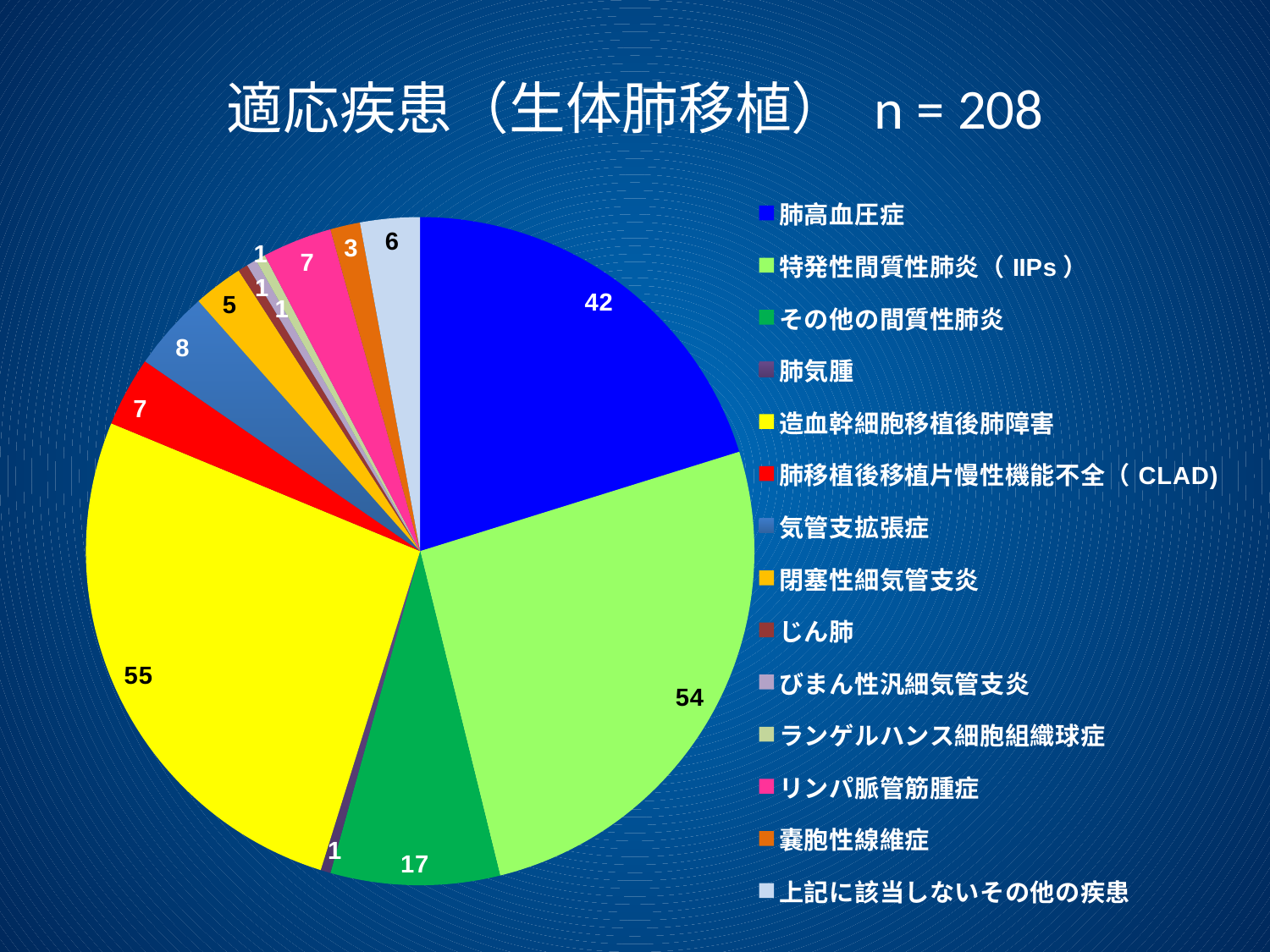
What is the value for 特発性間質性肺炎（IIPs）? 54 Which category has the largest slice of the pie? 造血幹細胞移植後肺障害 What is the difference between the values for 特発性間質性肺炎（IIPs） and 肺高血圧症? 12 How many categories does the legend list? 14 What is the value for 嚢胞性線維症? 3 What is the value for その他の間質性肺炎? 17 What is the value for 気管支拡張症? 8 What is the value for 造血幹細胞移植後肺障害? 55 What kind of chart is shown on the slide? pie chart What total number of cases (n) is stated in the chart title? 208 What is the value for 肺高血圧症? 42 Which is larger, the value for 気管支拡張症 or the value for 閉塞性細気管支炎? 気管支拡張症